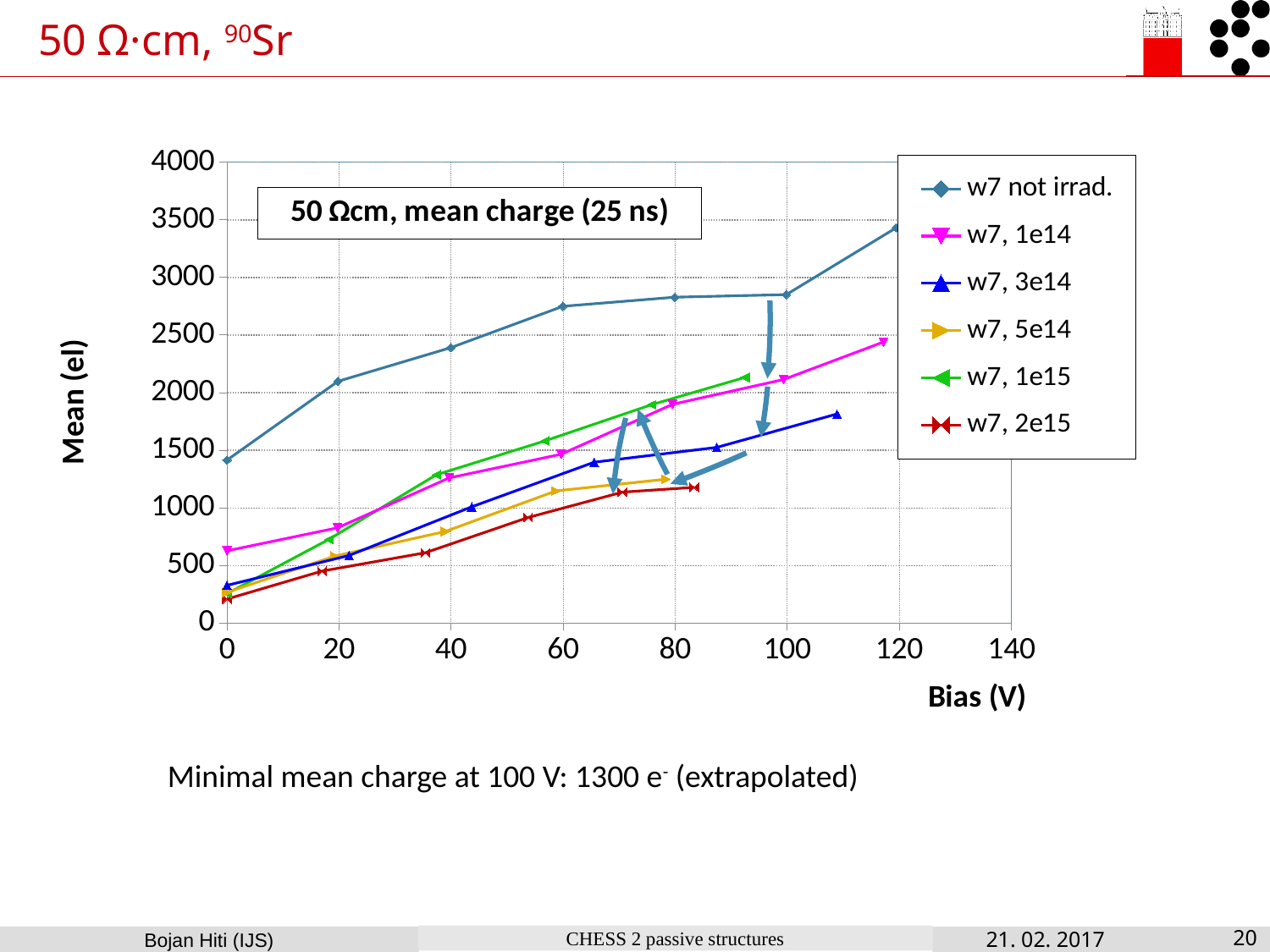
Is the value for w7, 1e14 at 120 V greater or less than 2000? greater At 100 V, which series has the larger mean charge: w7 not irrad. or w7, 1e14? w7 not irrad. What is the label of the x axis? Bias (V) What is the title shown inside the chart? 50 Ωcm, mean charge (25 ns) Is the value for w7, 2e15 at 0 V greater or less than 500? less Which series has the highest mean charge across the bias range? w7 not irrad. Is the value for w7 not irrad. at 100 V greater or less than 2500? greater Which series has the lowest mean charge across the bias range? w7, 2e15 How many series does the legend list? 6 What kind of chart is shown on the slide? line chart At 40 V, which series has the larger mean charge: w7, 1e14 or w7, 2e15? w7, 1e14 Does the mean charge for the w7 not irrad. series rise or fall as bias increases? rise